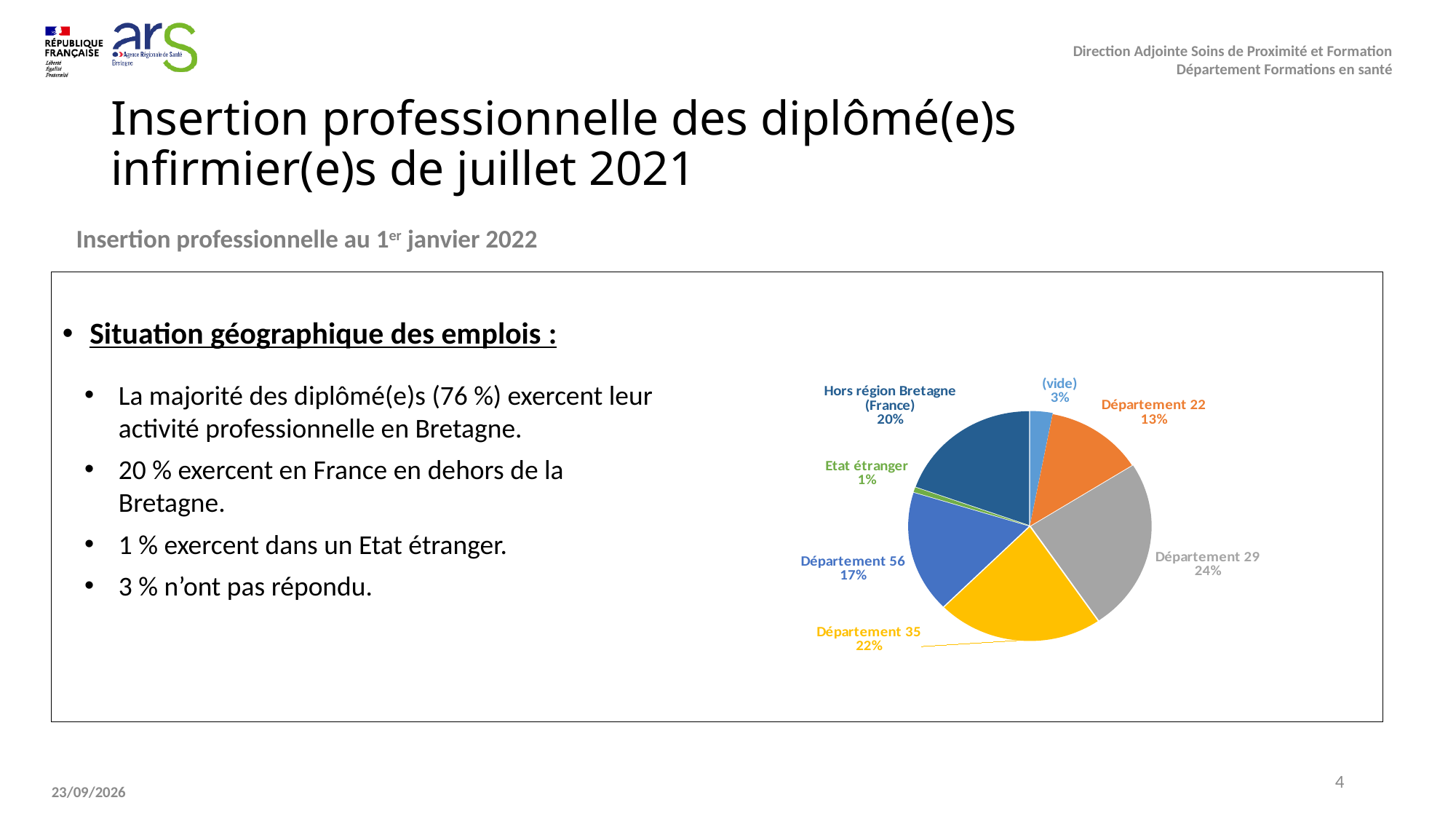
Which category has the smallest slice of the pie? Etat étranger What is the value shown for Département 56? 17% How many slices does the pie chart have? 7 What is the difference between the shares of Département 29 and Département 22? 11% What is the value shown for Etat étranger? 1% What share of the pie does Département 29 represent? 24% What is the value shown for Hors région Bretagne (France)? 20% Which is larger, the share for Département 56 or the share for Département 22? Département 56 Which category has the largest slice of the pie? Département 29 What is the value shown for Département 35? 22% What colour is the slice for Département 35? yellow What kind of chart is shown on the slide? pie chart